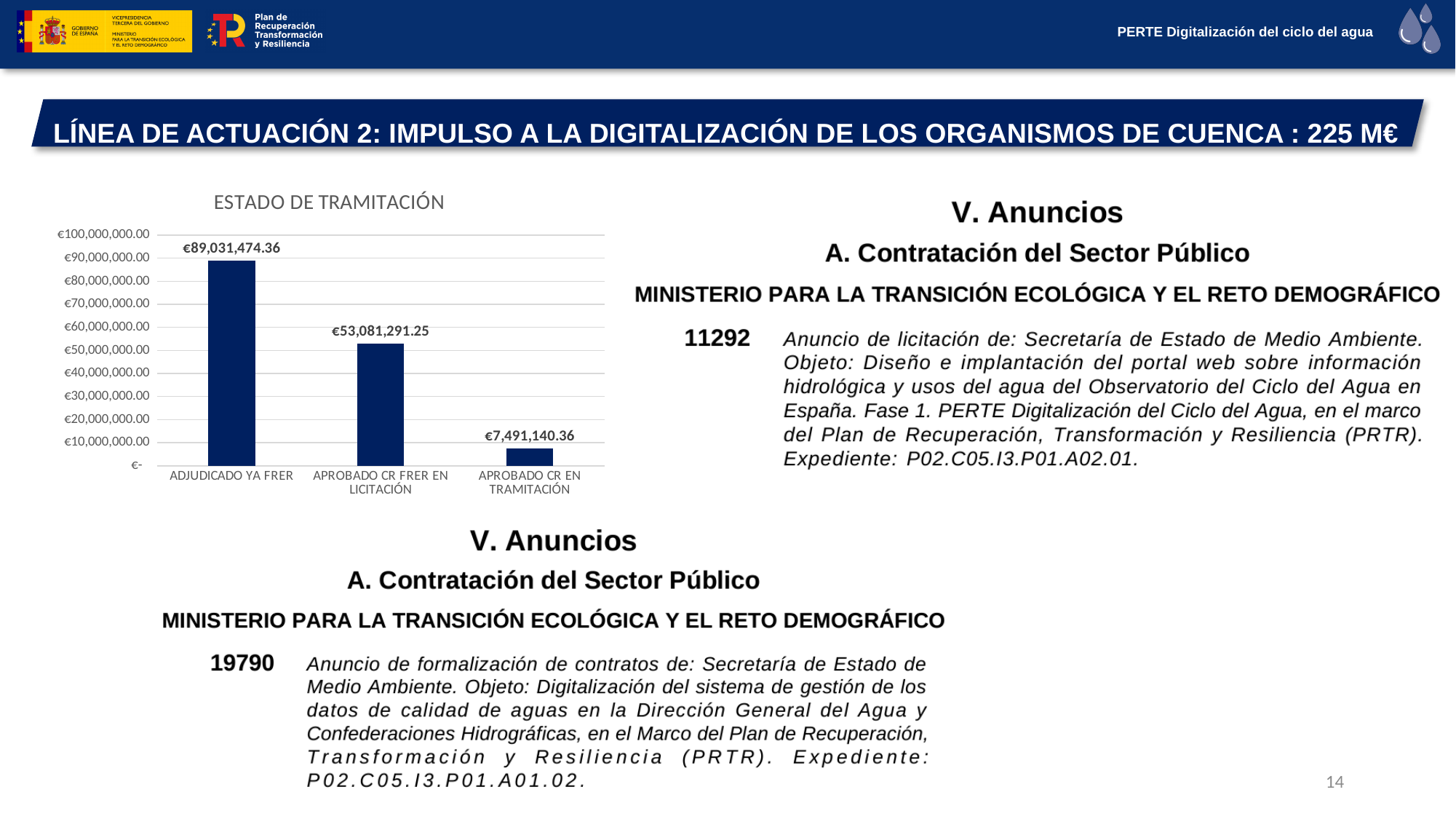
What is the title of the chart? ESTADO DE TRAMITACIÓN What is the value for APROBADO CR FRER EN LICITACIÓN? €53,081,291.25 Which category has the lowest value? APROBADO CR EN TRAMITACIÓN Which category has the highest value? ADJUDICADO YA FRER How many categories are shown in the chart? 3 What is the difference between the values for ADJUDICADO YA FRER and APROBADO CR FRER EN LICITACIÓN? €35,950,183.11 What kind of chart is shown on the slide? bar chart Which is larger, the value for APROBADO CR FRER EN LICITACIÓN or the value for APROBADO CR EN TRAMITACIÓN? APROBADO CR FRER EN LICITACIÓN What is the difference between the values for APROBADO CR FRER EN LICITACIÓN and APROBADO CR EN TRAMITACIÓN? €45,590,150.89 What is the value for APROBADO CR EN TRAMITACIÓN? €7,491,140.36 What is the value for ADJUDICADO YA FRER? €89,031,474.36 Is the value for APROBADO CR EN TRAMITACIÓN greater or less than €10,000,000.00? less